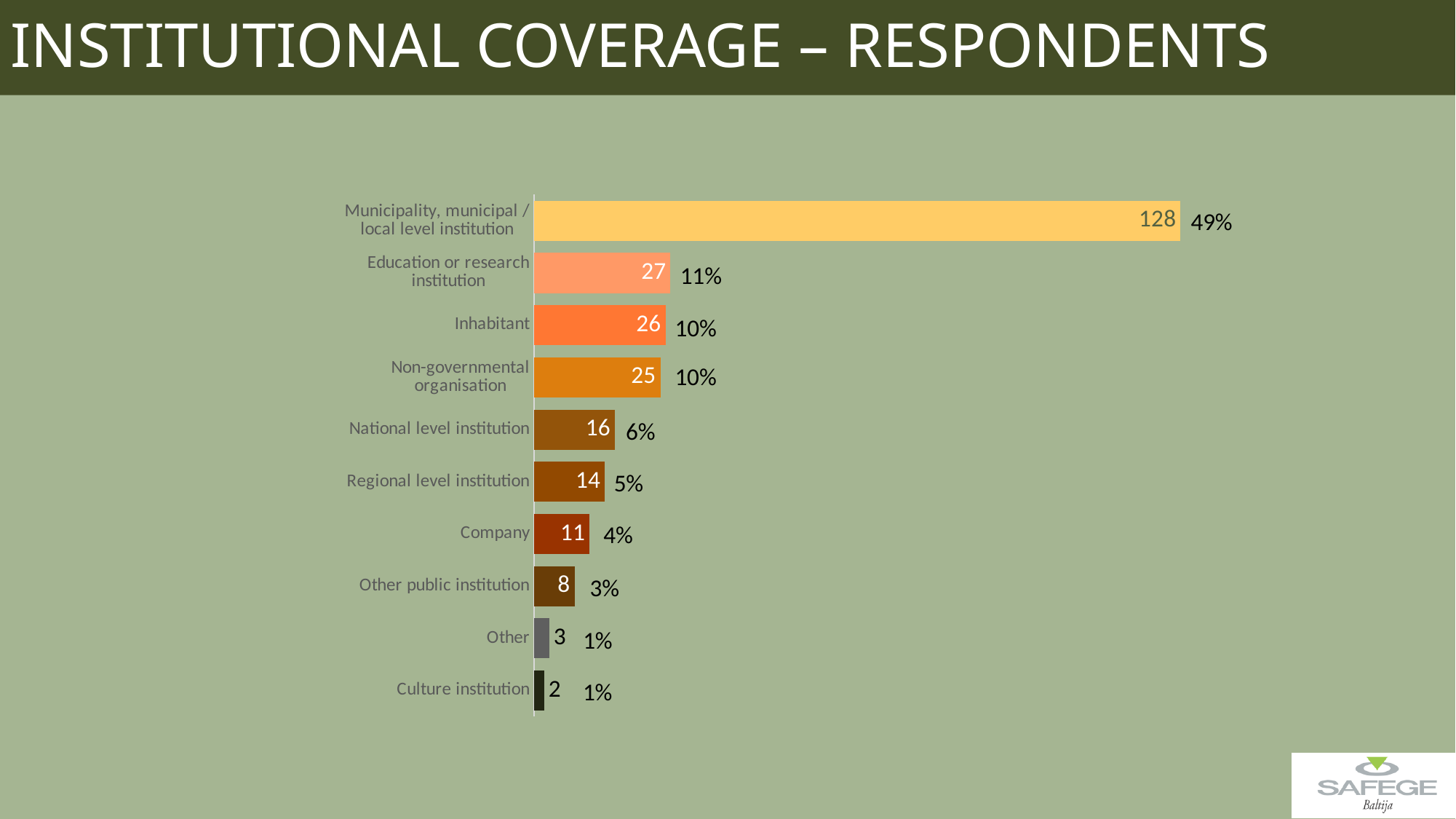
Which category has the lowest number of respondents? Culture institution How many respondents are inhabitants? 26 Which category has the highest number of respondents? Municipality, municipal / local level institution What percentage of respondents are from an education or research institution? 11% How many categories are shown in the chart? 10 What is the difference in respondents between Municipality, municipal / local level institution and Education or research institution? 101 What is the title of the slide? INSTITUTIONAL COVERAGE – RESPONDENTS How many respondents are from a non-governmental organisation? 25 What type of chart is shown on the slide? Bar chart Which has more respondents, Company or Other public institution? Company What is the difference in respondents between National level institution and Regional level institution? 2 How many respondents are from a municipality, municipal / local level institution? 128